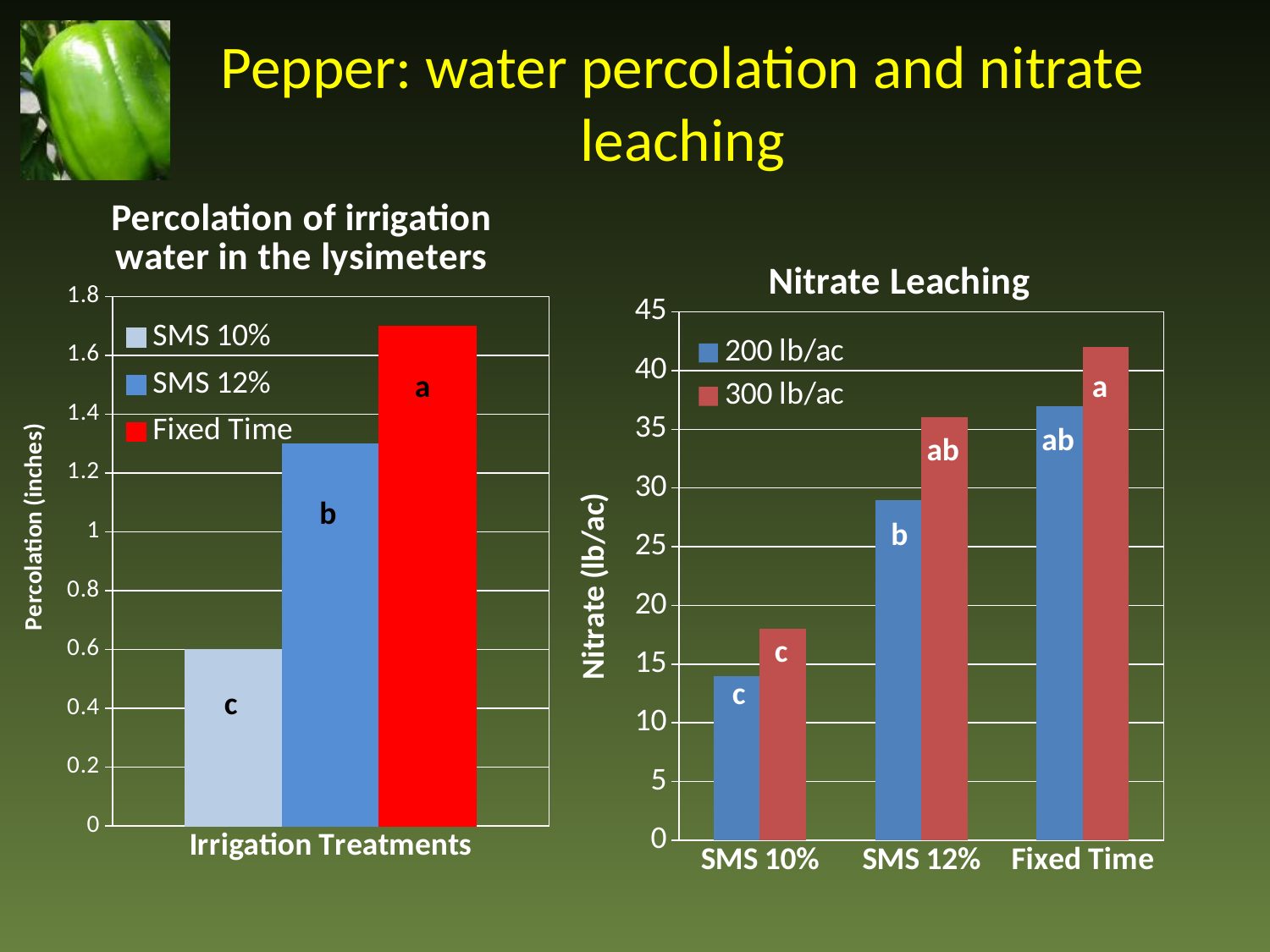
In the 'Percolation of irrigation water in the lysimeters' chart, how many series does the legend list? 3 In the 'Nitrate Leaching' chart, is the 200 lb/ac value for SMS 10% greater or less than 15? less In the 'Percolation of irrigation water in the lysimeters' chart, is the value for Fixed Time greater or less than 1.6? greater In the 'Nitrate Leaching' chart, which treatment has the highest nitrate leaching for the 300 lb/ac series? Fixed Time What kind of chart is the 'Percolation of irrigation water in the lysimeters' chart? bar chart In the 'Nitrate Leaching' chart, how many series does the legend list? 2 In the 'Percolation of irrigation water in the lysimeters' chart, what is the y-axis title? Percolation (inches) In the 'Nitrate Leaching' chart, for SMS 12%, which series has the larger value, 200 lb/ac or 300 lb/ac? 300 lb/ac In the 'Percolation of irrigation water in the lysimeters' chart, which treatment has the lowest percolation? SMS 10% In the 'Nitrate Leaching' chart, how many irrigation treatment categories are shown on the x axis? 3 In the 'Percolation of irrigation water in the lysimeters' chart, which treatment has the highest percolation? Fixed Time In the 'Percolation of irrigation water in the lysimeters' chart, what is the percolation value for SMS 10%? 0.6